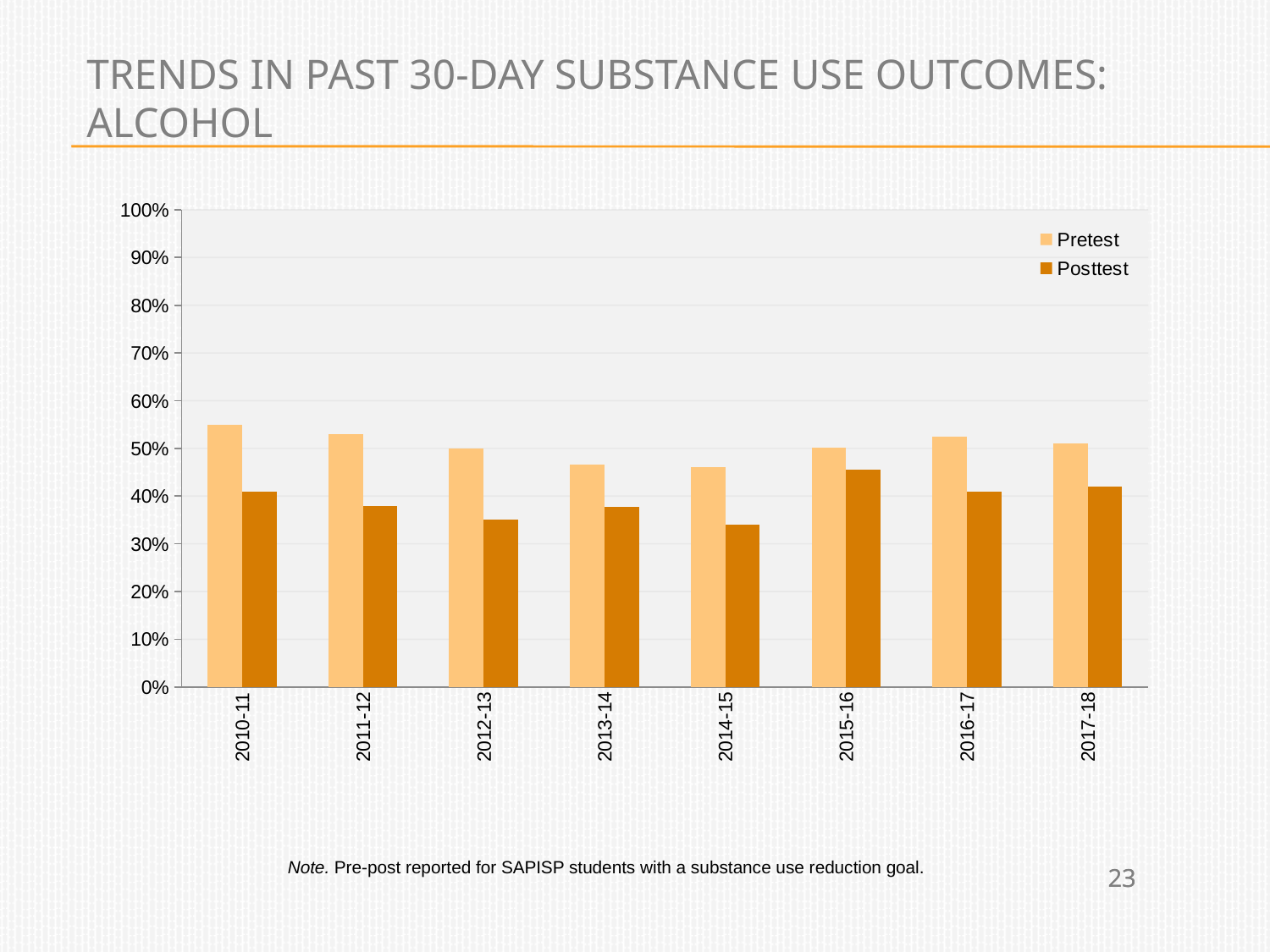
In 2010-11, which is larger, the Pretest value or the Posttest value? Pretest What type of chart is shown on the slide? bar chart What are the two series named in the legend? Pretest and Posttest Which is larger, the Posttest value for 2015-16 or the Posttest value for 2012-13? 2015-16 Is the Posttest value for 2015-16 greater or less than 40%? greater Is the Posttest value for 2014-15 greater or less than 40%? less Which year has the highest Posttest value? 2015-16 How many series does the legend list? 2 How many school years are shown on the x axis? 8 Is the Pretest value for 2013-14 greater or less than 50%? less Which year has the highest Pretest value? 2010-11